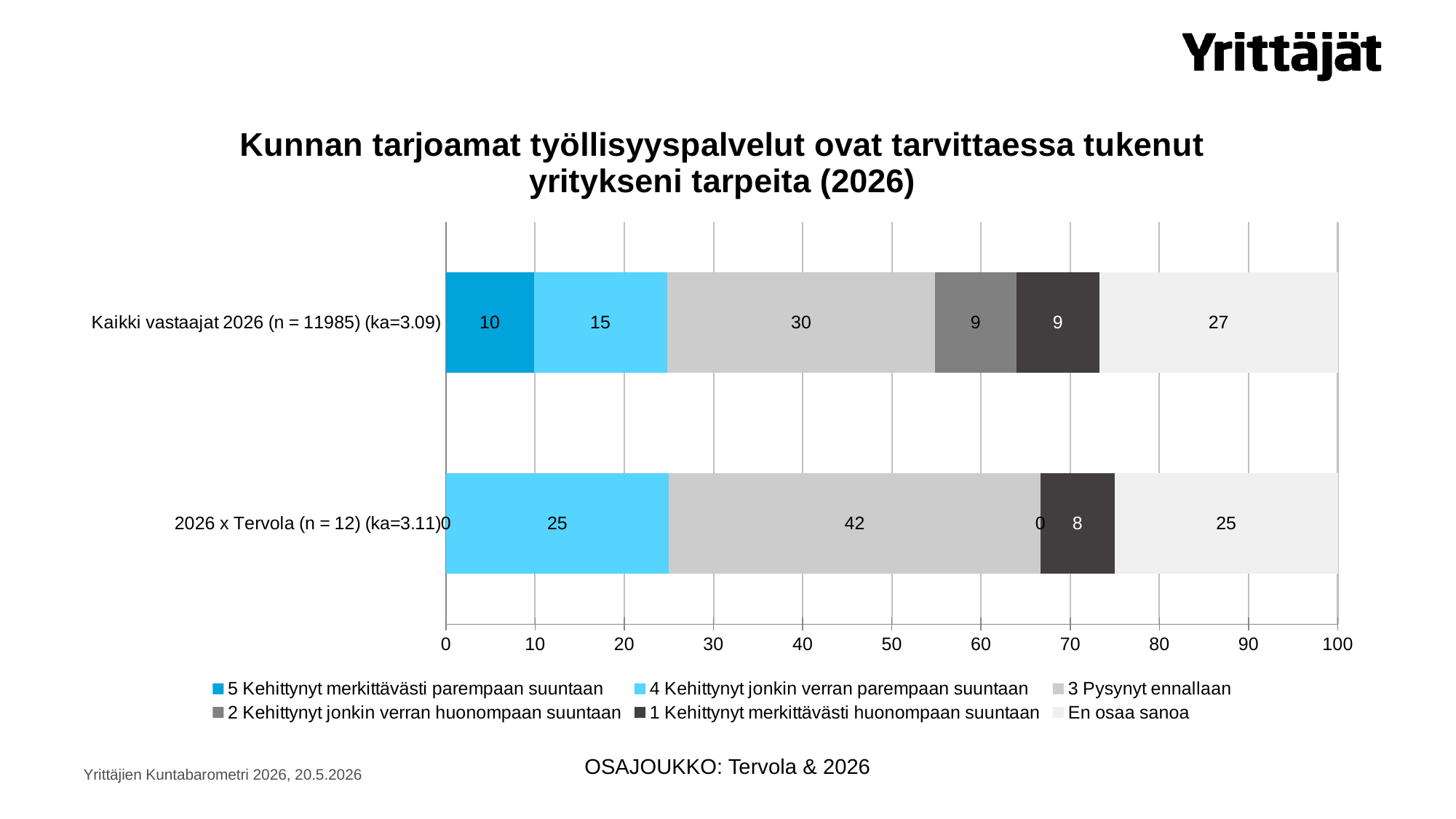
What is the total of the stacked bar for 'Kaikki vastaajat 2026 (n = 11985) (ka=3.09)'? 100 What is the value of '4 Kehittynyt jonkin verran parempaan suuntaan' for '2026 x Tervola (n = 12) (ka=3.11)'? 25 What is the value of 'En osaa sanoa' for 'Kaikki vastaajat 2026 (n = 11985) (ka=3.09)'? 27 How many series does the legend list? 6 How many categories (bars) are shown in the chart? 2 Which series has the highest value in the '2026 x Tervola (n = 12) (ka=3.11)' bar? 3 Pysynyt ennallaan What kind of chart is shown on the slide? Stacked bar chart What is the value of '3 Pysynyt ennallaan' for 'Kaikki vastaajat 2026 (n = 11985) (ka=3.09)'? 30 What is the difference between the '3 Pysynyt ennallaan' values for '2026 x Tervola (n = 12) (ka=3.11)' and 'Kaikki vastaajat 2026 (n = 11985) (ka=3.09)'? 12 Which is larger: the '4 Kehittynyt jonkin verran parempaan suuntaan' value for 'Kaikki vastaajat 2026 (n = 11985) (ka=3.09)' or for '2026 x Tervola (n = 12) (ka=3.11)'? 2026 x Tervola (n = 12) (ka=3.11) What is the value of '5 Kehittynyt merkittävästi parempaan suuntaan' for '2026 x Tervola (n = 12) (ka=3.11)'? 0 What is the value of '1 Kehittynyt merkittävästi huonompaan suuntaan' for '2026 x Tervola (n = 12) (ka=3.11)'? 8